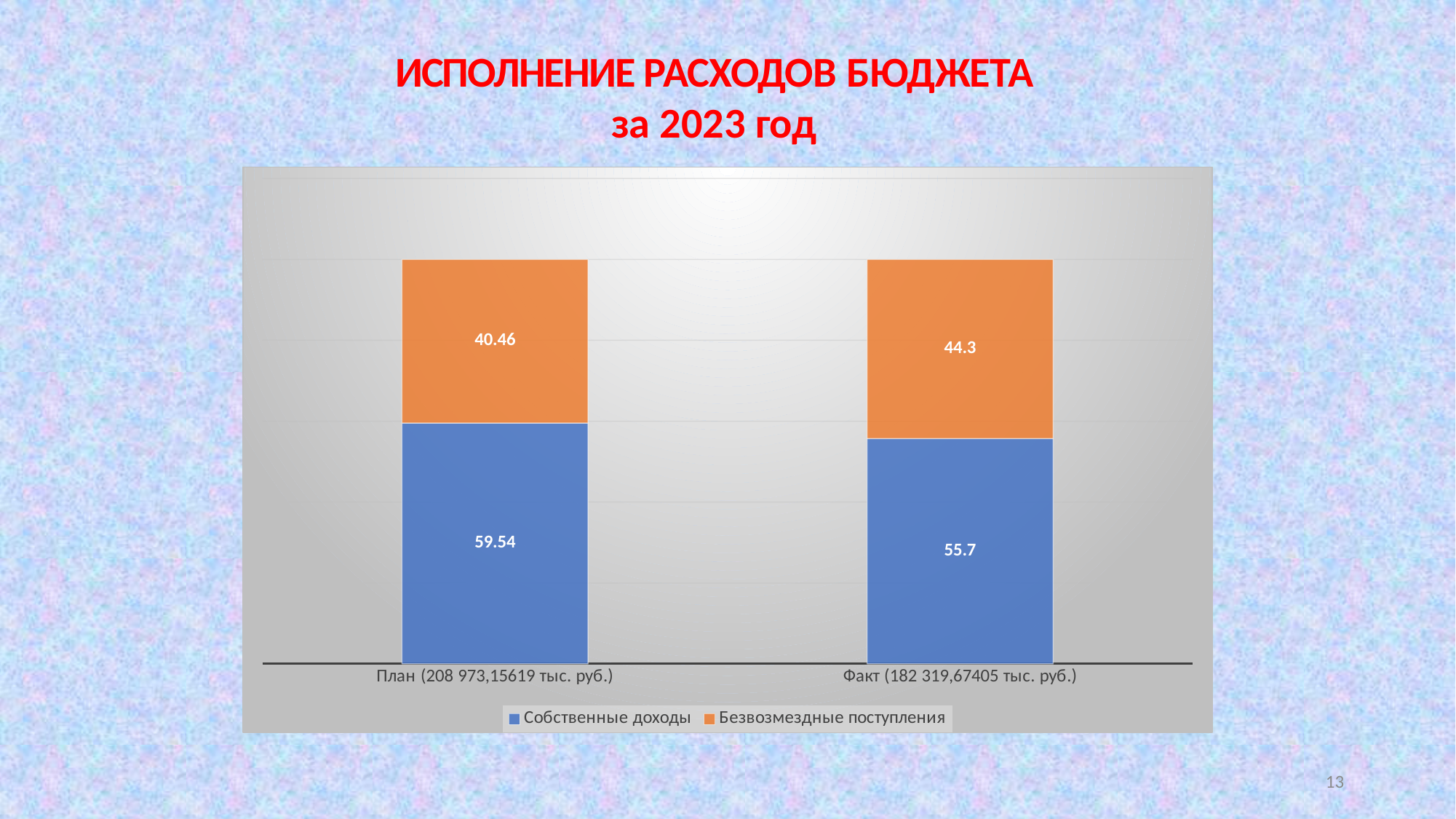
What is the value of Собственные доходы for Факт (182 319,67405 тыс. руб.)? 55.7 What is the difference between the Собственные доходы values for План and Факт? 3.84 What is the difference between the Безвозмездные поступления values for Факт and План? 3.84 Which colour represents Безвозмездные поступления in the chart? Orange How many series does the legend list? 2 What is the total of the stacked bar for Факт (182 319,67405 тыс. руб.)? 100 How many categories are shown on the x axis? 2 What is the value of Собственные доходы for План (208 973,15619 тыс. руб.)? 59.54 What kind of chart is shown on the slide? Stacked bar chart What is the value of Безвозмездные поступления for План (208 973,15619 тыс. руб.)? 40.46 Which category has the higher value for Безвозмездные поступления, План or Факт? Факт (182 319,67405 тыс. руб.) What is the value of Безвозмездные поступления for Факт (182 319,67405 тыс. руб.)? 44.3